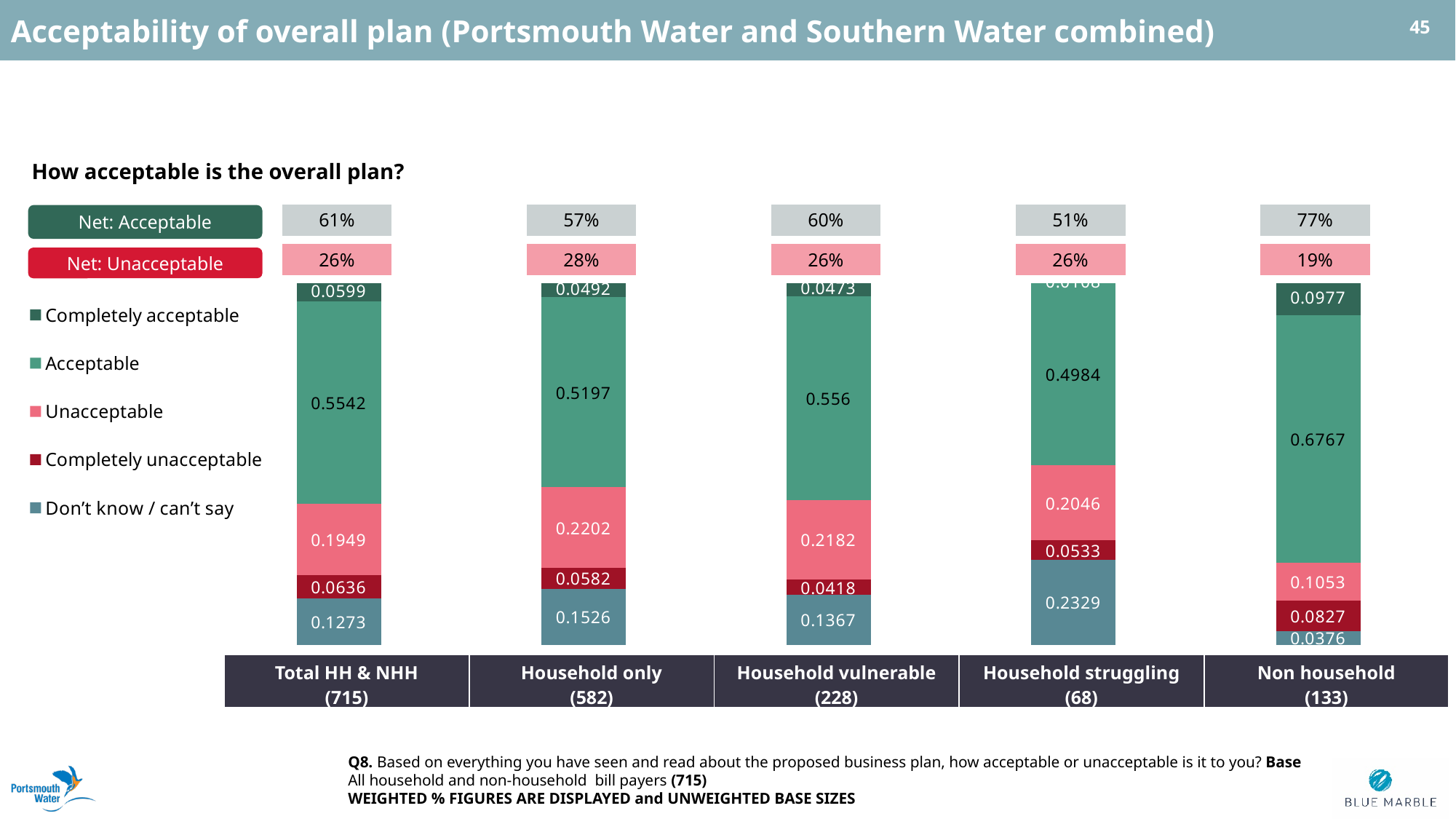
Which has the larger 'Completely unacceptable' value: Total HH & NHH or Household vulnerable? Total HH & NHH What is the 'Completely acceptable' value for the Total HH & NHH group? 0.0599 Which group has the lowest Net: Acceptable figure? Household struggling How many series does the chart legend list? 5 How many respondent groups (categories) are shown along the x axis of the chart? 5 What is the 'Don't know / can't say' value for the Household struggling group? 0.2329 What is the difference between the Net: Acceptable figures for Non household and Household struggling? 26 percentage points Which group has the highest Net: Acceptable figure? Non household What is the Net: Unacceptable figure for the Household only group? 28% What is the 'Acceptable' value for the Non household group? 0.6767 Which group has the largest 'Don't know / can't say' segment? Household struggling What kind of chart is shown on the slide? Stacked bar chart